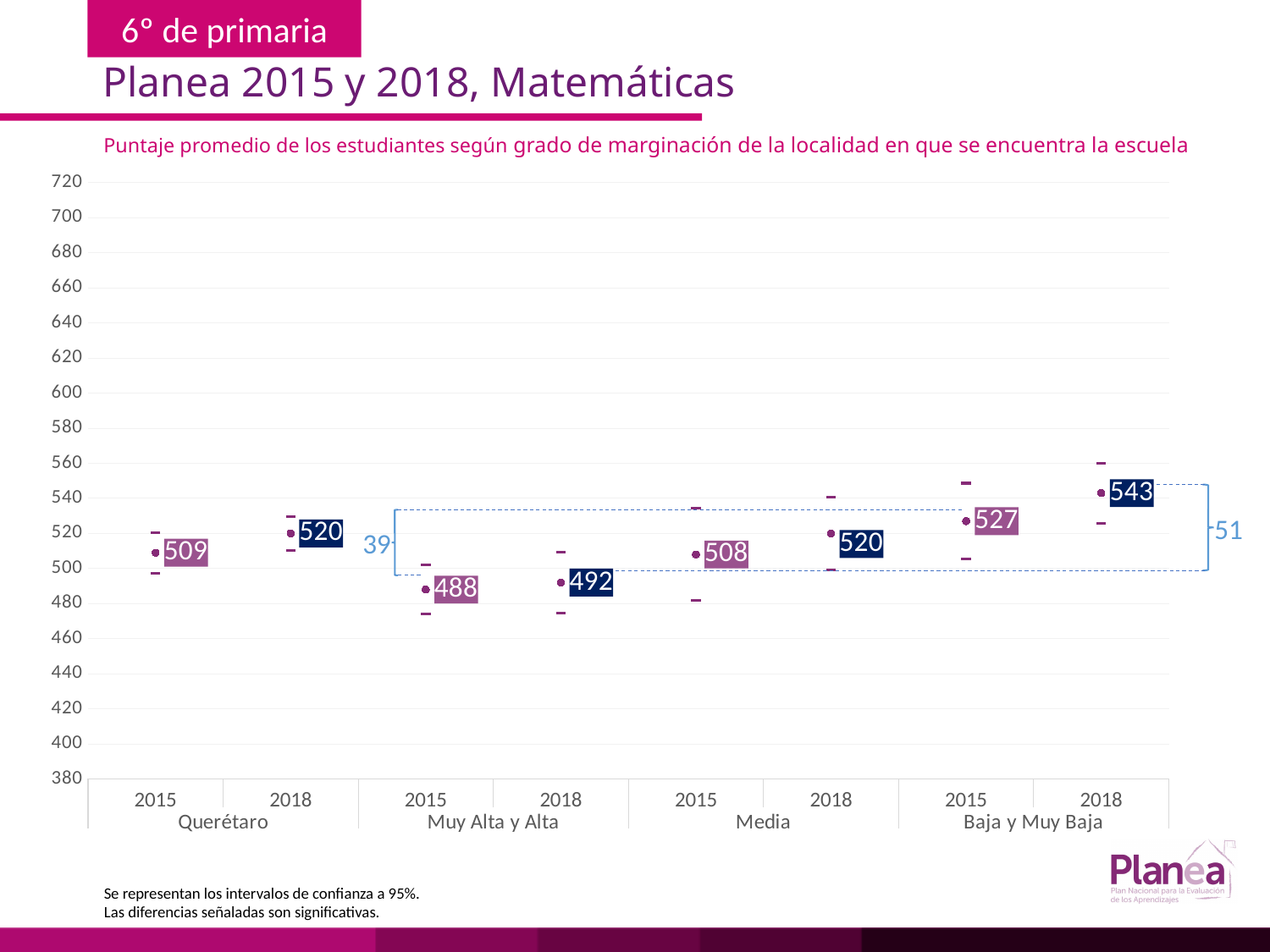
How many marginalization groups are shown on the x axis? 4 What is the average score for Media in 2018? 520 Which group and year has the lowest average score? Muy Alta y Alta, 2015 What is the difference between the 2018 and 2015 scores for Querétaro? 11 What is the subtitle of the chart? Puntaje promedio de los estudiantes según grado de marginación de la localidad en que se encuentra la escuela Which group and year has the highest average score? Baja y Muy Baja, 2018 Did the average score rise or fall from 2015 to 2018 for Media? rise What is the difference between the 2018 and 2015 scores for Baja y Muy Baja? 16 Which is larger, the 2018 score for Media or the 2018 score for Muy Alta y Alta? Media What is the average score for Baja y Muy Baja in 2018? 543 What is the average score for Muy Alta y Alta in 2015? 488 What is the average score for Querétaro in 2015? 509